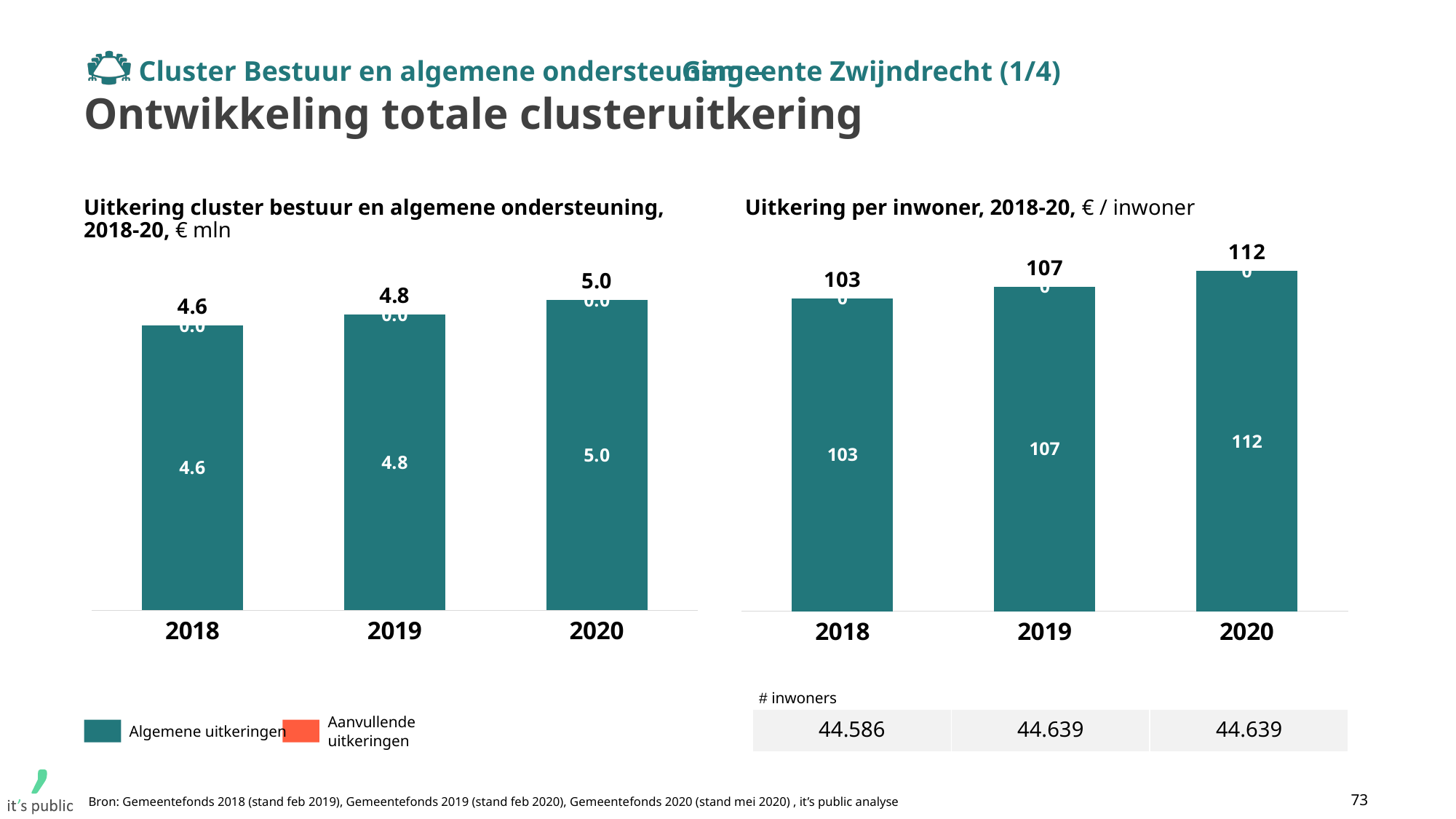
In the chart 'Uitkering per inwoner, 2018-20', what is the value for 2019? 107 In the chart 'Uitkering per inwoner, 2018-20', is the value for 2019 larger or smaller than the value for 2018? larger In the chart 'Uitkering per inwoner, 2018-20', what is the difference between the values for 2020 and 2018? 9 In the chart 'Uitkering cluster bestuur en algemene ondersteuning, 2018-20', what is the total value for 2020? 5.0 In the chart 'Uitkering per inwoner, 2018-20', which year has the highest value? 2020 In the chart 'Uitkering cluster bestuur en algemene ondersteuning, 2018-20', which year has the lowest total value? 2018 How many series does the legend of the chart 'Uitkering cluster bestuur en algemene ondersteuning, 2018-20' list? 2 How many years are shown on the x axis of the chart 'Uitkering per inwoner, 2018-20'? 3 In the chart 'Uitkering cluster bestuur en algemene ondersteuning, 2018-20', do the total values rise or fall from 2018 to 2020? rise In the chart 'Uitkering cluster bestuur en algemene ondersteuning, 2018-20', what is the difference between the totals for 2020 and 2019? 0.2 What kind of chart is 'Uitkering per inwoner, 2018-20'? bar chart In the chart 'Uitkering cluster bestuur en algemene ondersteuning, 2018-20', what is the total value for 2018? 4.6